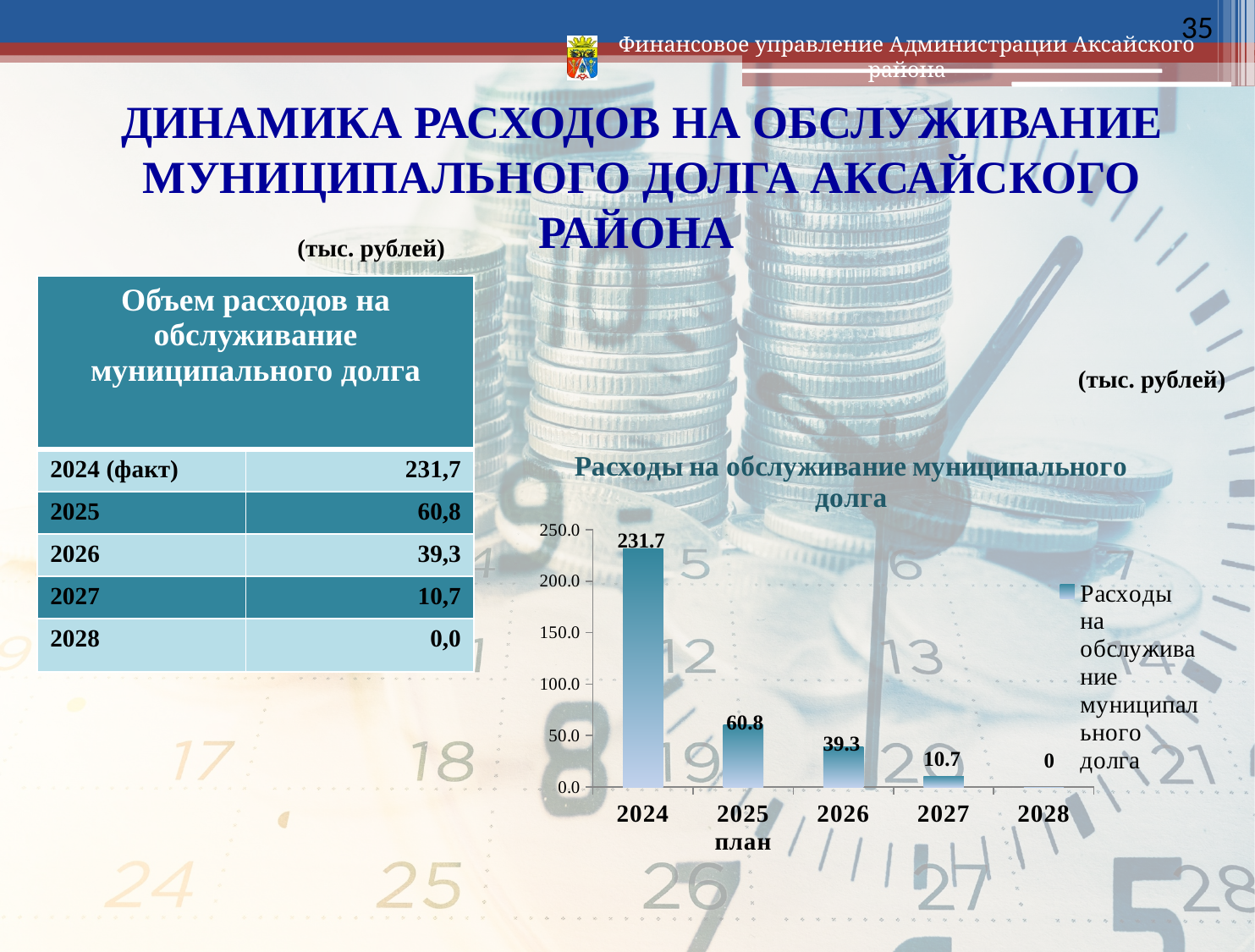
Do the values rise or fall from 2024 to 2028 along the x axis? Fall What is the value for 2028 in the chart? 0 How many categories are shown on the x axis of the chart? 5 What is the value for 2026 in the chart? 39.3 What is the value for 2025 план in the chart? 60.8 What is the value for 2027 in the chart? 10.7 Which year has the highest value in the chart? 2024 Which year has the lowest value in the chart? 2028 What is the value for 2024 in the chart? 231.7 Which is larger, the value for 2026 or the value for 2027? 2026 What is the difference between the values for 2024 and 2025 план? 170.9 What type of chart is shown on the slide? Bar chart